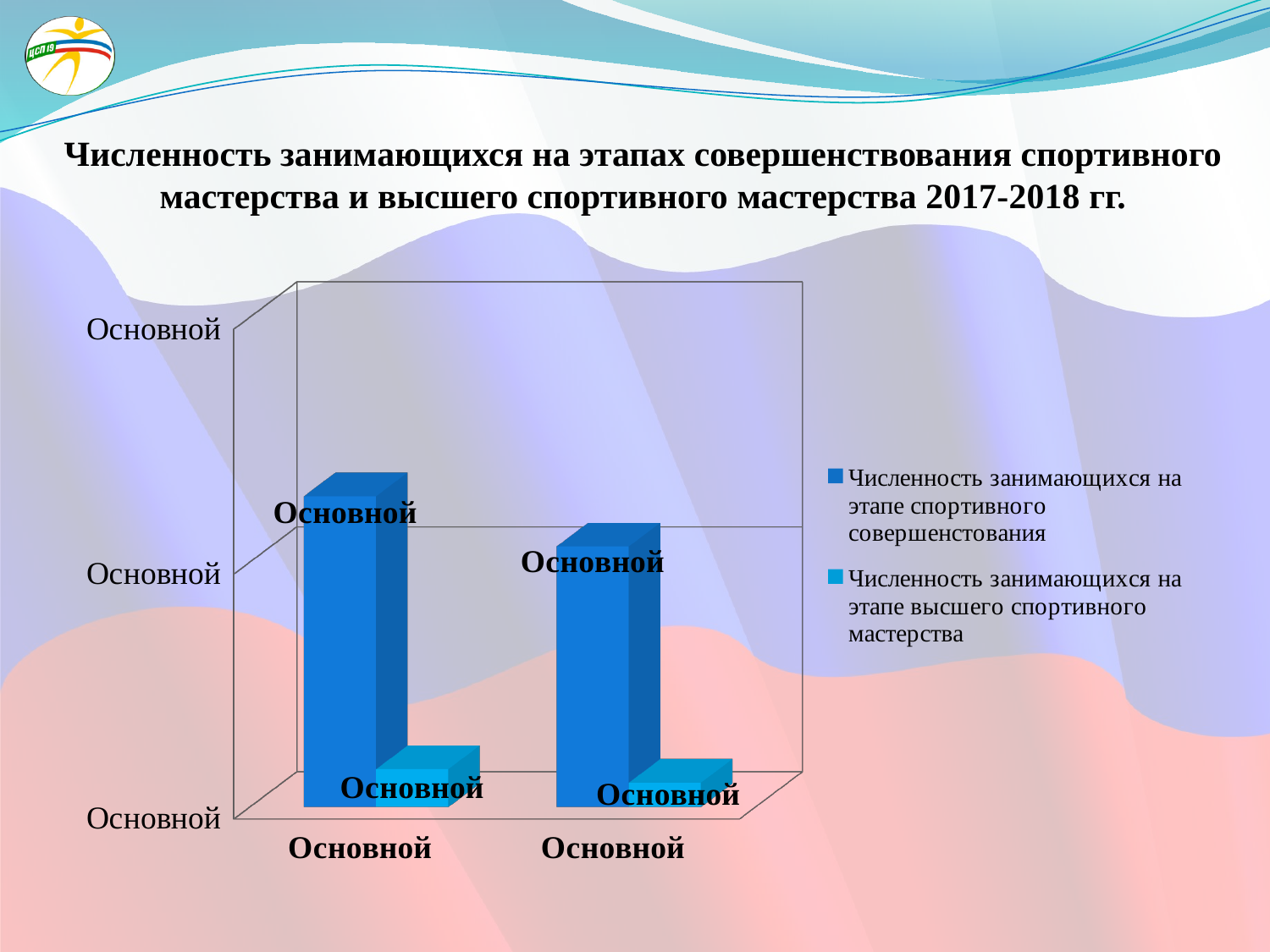
In the right group of bars, which series has the smaller value? Численность занимающихся на этапе высшего спортивного мастерства What is the first legend entry of the chart? Численность занимающихся на этапе спортивного совершенстования Which series is shown in the lighter blue colour? Численность занимающихся на этапе высшего спортивного мастерства Does the series 'Численность занимающихся на этапе спортивного совершенстования' rise or fall from the left group to the right group? fall How many bars are plotted in total on the chart? 4 How many series does the legend list? 2 What kind of chart is shown on the slide? bar chart How many groups of bars are plotted along the x axis? 2 For the series 'Численность занимающихся на этапе спортивного совершенстования', is the left bar or the right bar taller? left In the left group of bars, which series has the larger value? Численность занимающихся на этапе спортивного совершенстования